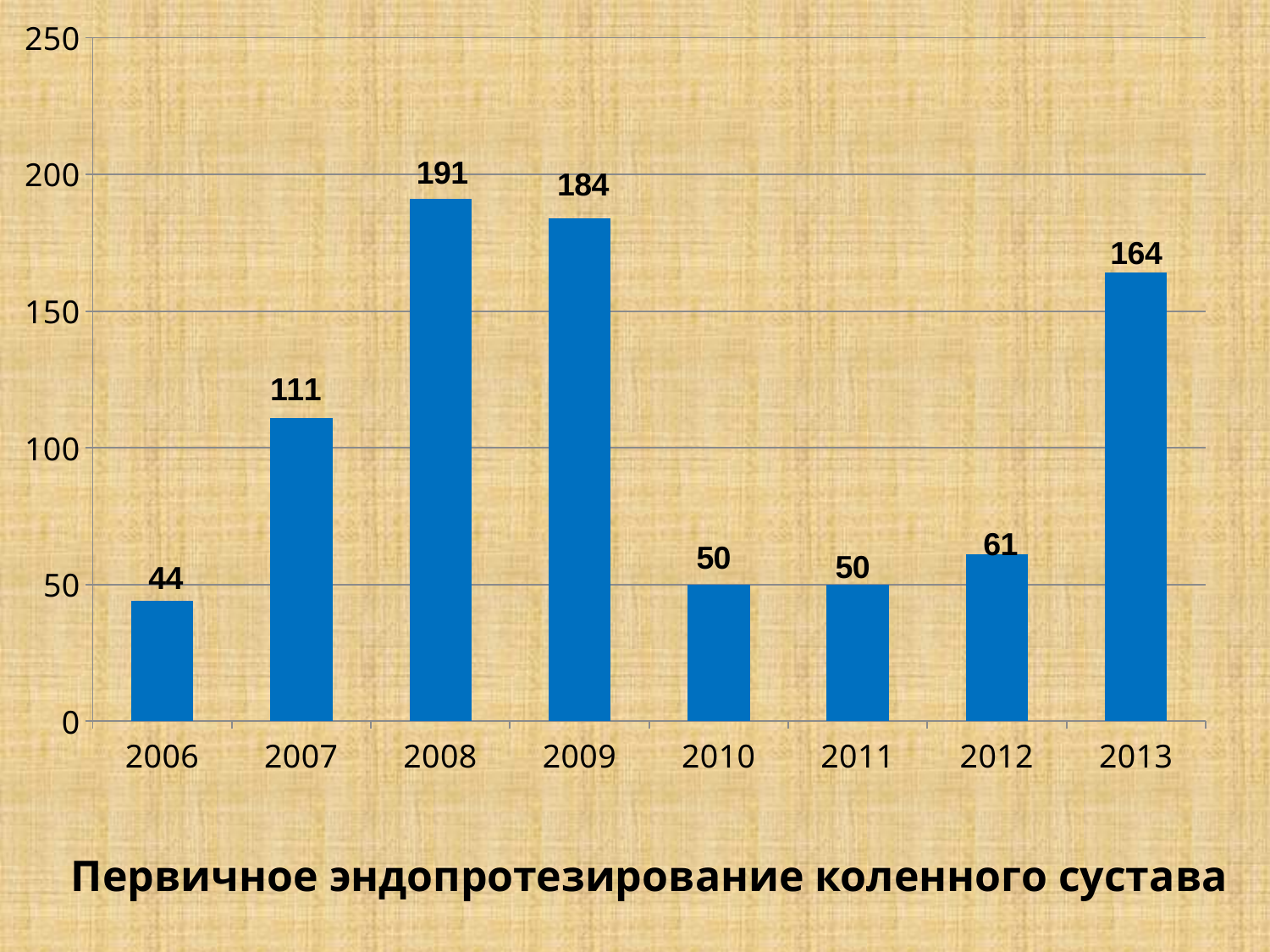
What is the value for 2006? 44 What is the title text shown below the chart? Первичное эндопротезирование коленного сустава Which year has the lowest value? 2006 What is the difference between the values for 2008 and 2009? 7 What is the difference between the values for 2013 and 2012? 103 Which year has the highest value? 2008 Is the value for 2009 greater or less than 150? greater What is the value for 2013? 164 How many years are shown on the x axis? 8 Which is larger, the value for 2007 or the value for 2012? 2007 What is the value for 2008? 191 What kind of chart is shown on the slide? bar chart